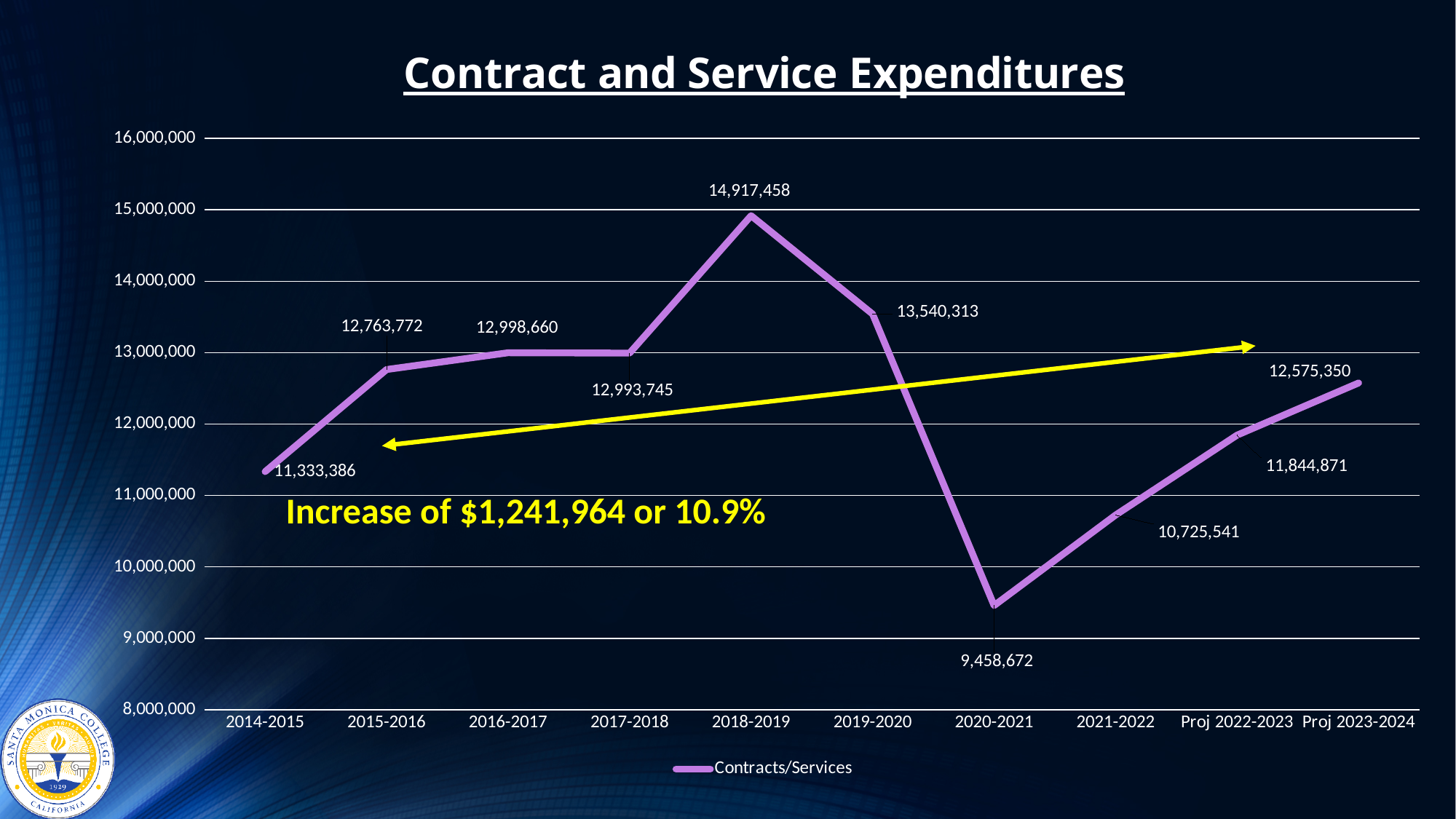
What is the value for 2014-2015? 11,333,386 What is the value for Proj 2023-2024? 12,575,350 Which year has the lowest value? 2020-2021 How many years are plotted on the x axis? 10 What is the value for 2020-2021? 9,458,672 Which is larger, the value for 2019-2020 or the value for 2021-2022? 2019-2020 What is the difference between the values for 2021-2022 and 2020-2021? 1,266,869 What series name does the legend show? Contracts/Services What is the difference between the values for 2018-2019 and 2020-2021? 5,458,786 Which year has the highest value? 2018-2019 What is the value for 2018-2019? 14,917,458 What type of chart is shown on the slide? line chart